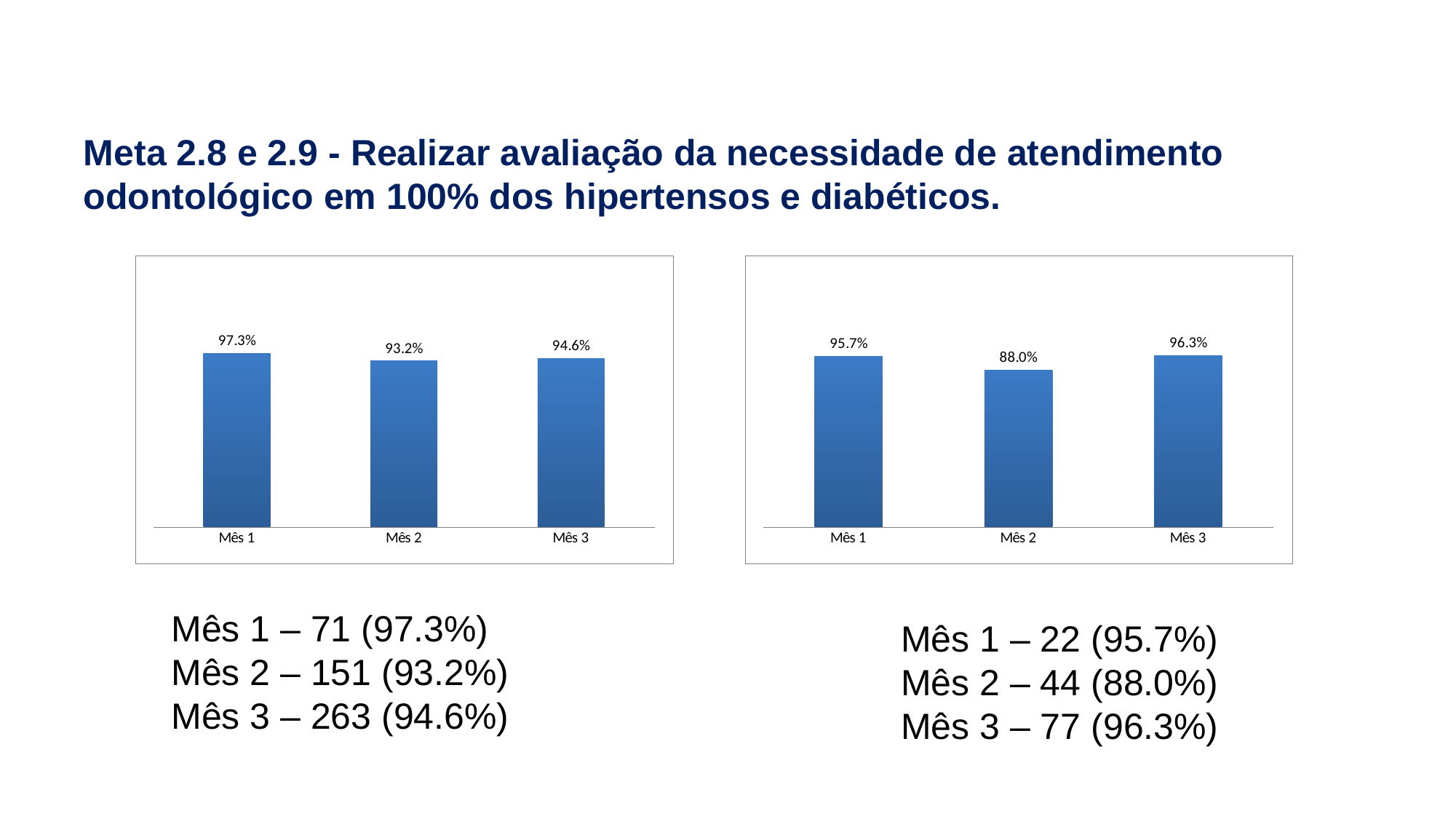
In the left chart, what is the value for Mês 1? 97.3% In the right chart, which month has the highest value? Mês 3 In the left chart, which month has the highest value? Mês 1 In the left chart, which is larger, the value for Mês 3 or the value for Mês 2? Mês 3 How many bars are in the right chart? 3 In the left chart, what is the difference between the values for Mês 1 and Mês 2? 4.1% In the right chart, what is the value for Mês 2? 88.0% In the right chart, what is the difference between the values for Mês 3 and Mês 2? 8.3% What kind of chart is the left chart? Bar chart In the right chart, which month has the lowest value? Mês 2 In the right chart, what is the value for Mês 3? 96.3% In the left chart, what is the value for Mês 2? 93.2%